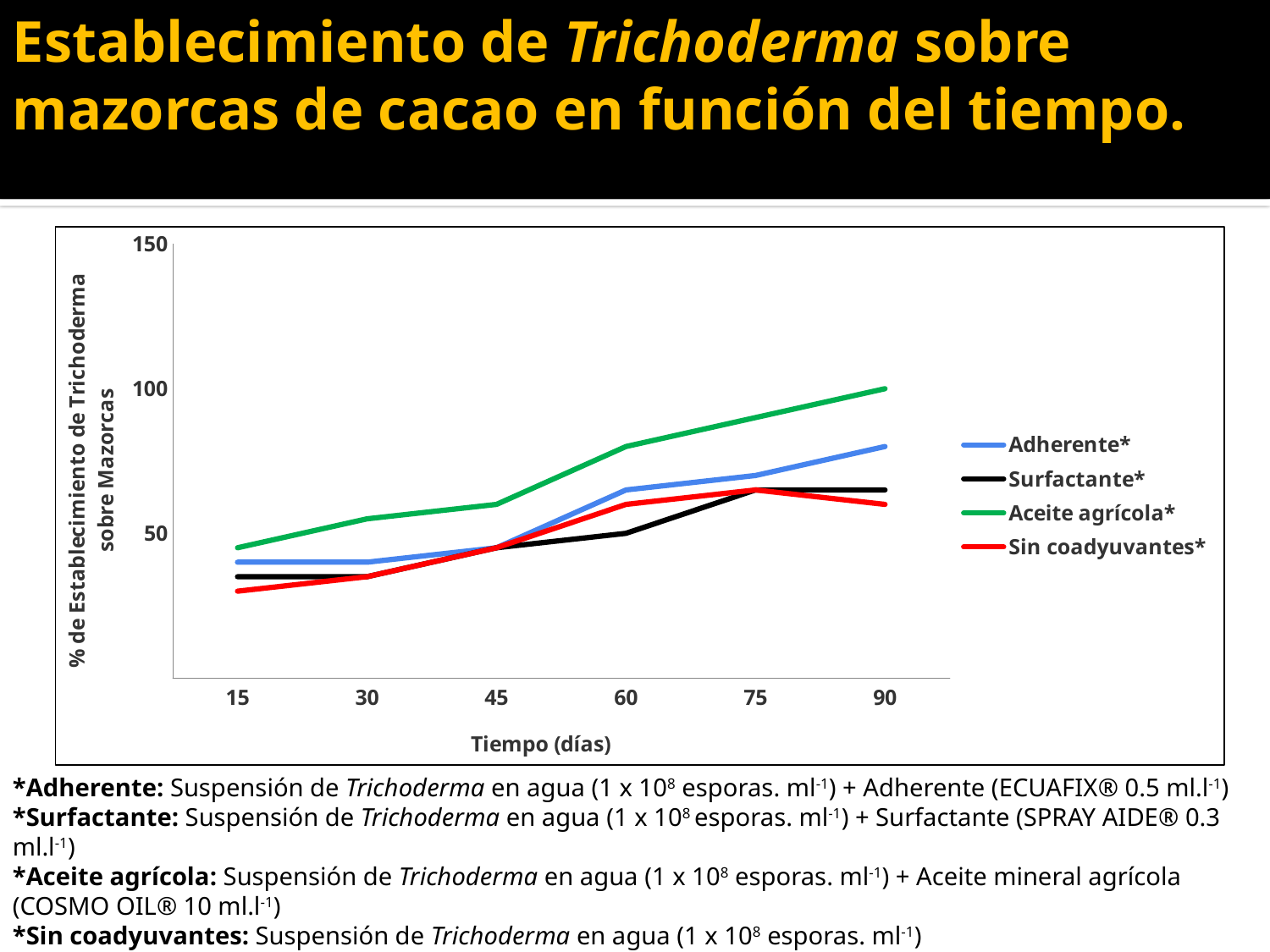
Which series has the highest value at 90 days? Aceite agrícola* What is the title of the x axis? Tiempo (días) Is the value for Aceite agrícola* at 60 days greater or less than 50? greater What kind of chart is shown on the slide? line chart Is the value for Sin coadyuvantes* at 15 days greater or less than 50? less Which series has the lowest value at 15 days? Sin coadyuvantes* How many series does the legend list? 4 Does the Sin coadyuvantes* series rise or fall between 75 and 90 days? fall Is the value for Adherente* at 90 days greater or less than 100? less How many time points are plotted along the x axis? 6 Does the Aceite agrícola* series rise or fall from 15 to 90 days? rise Which series has the highest value at 60 days? Aceite agrícola*